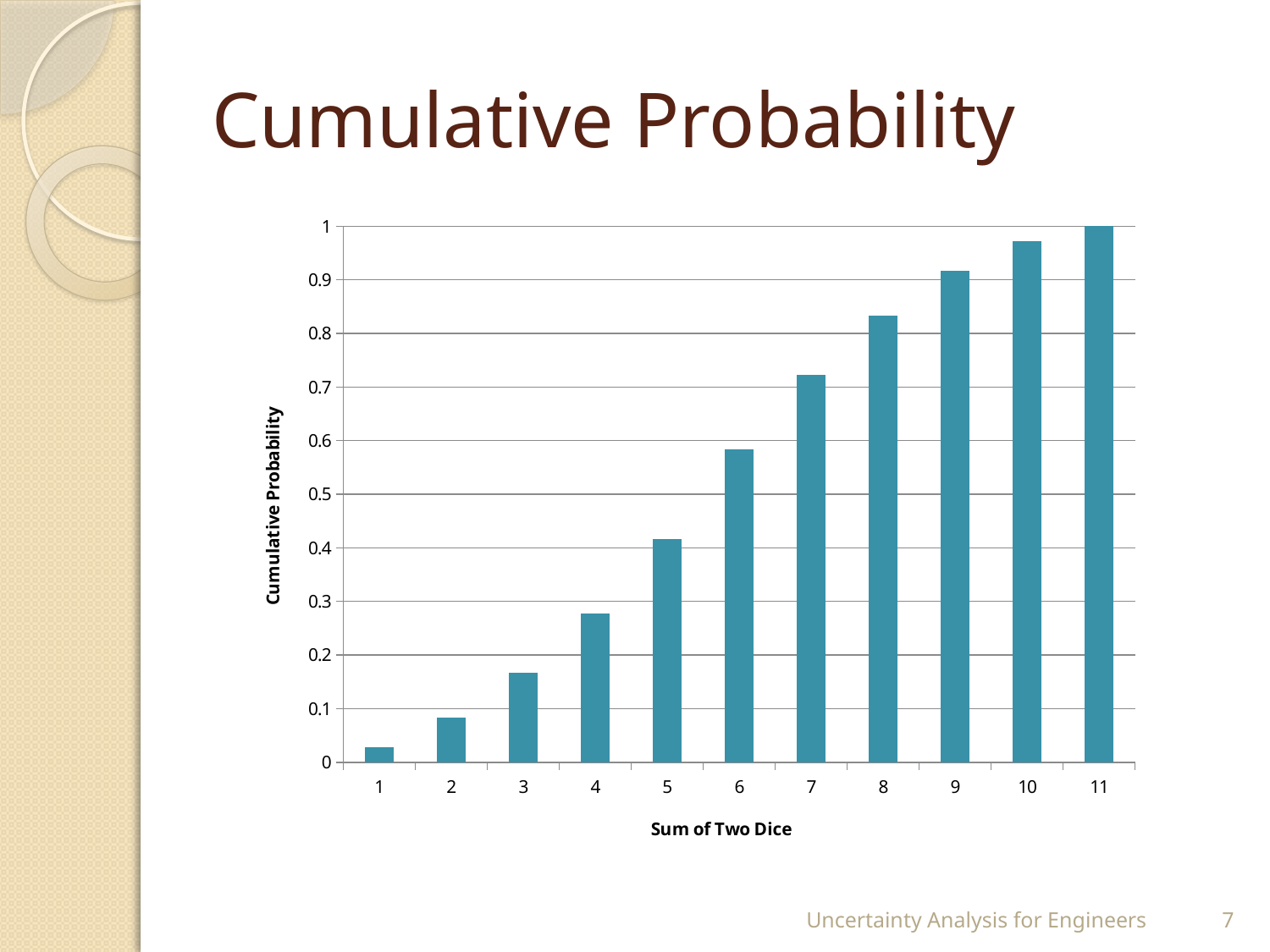
Which sum has the highest cumulative probability? 11 Which has the larger cumulative probability, a sum of 7 or a sum of 5? 7 What is the title of the x axis of the chart? Sum of Two Dice Is the cumulative probability for a sum of 4 greater or less than 0.3? less Which sum has the lowest cumulative probability? 1 Is the cumulative probability for a sum of 8 greater or less than 0.8? greater What type of chart is shown on the slide? bar chart What is the cumulative probability for a sum of 11? 1 Is the cumulative probability for a sum of 3 greater or less than 0.2? less How many categories (sums) are plotted along the x axis? 11 Do the cumulative probability values rise or fall as the sum increases from 1 to 11? rise